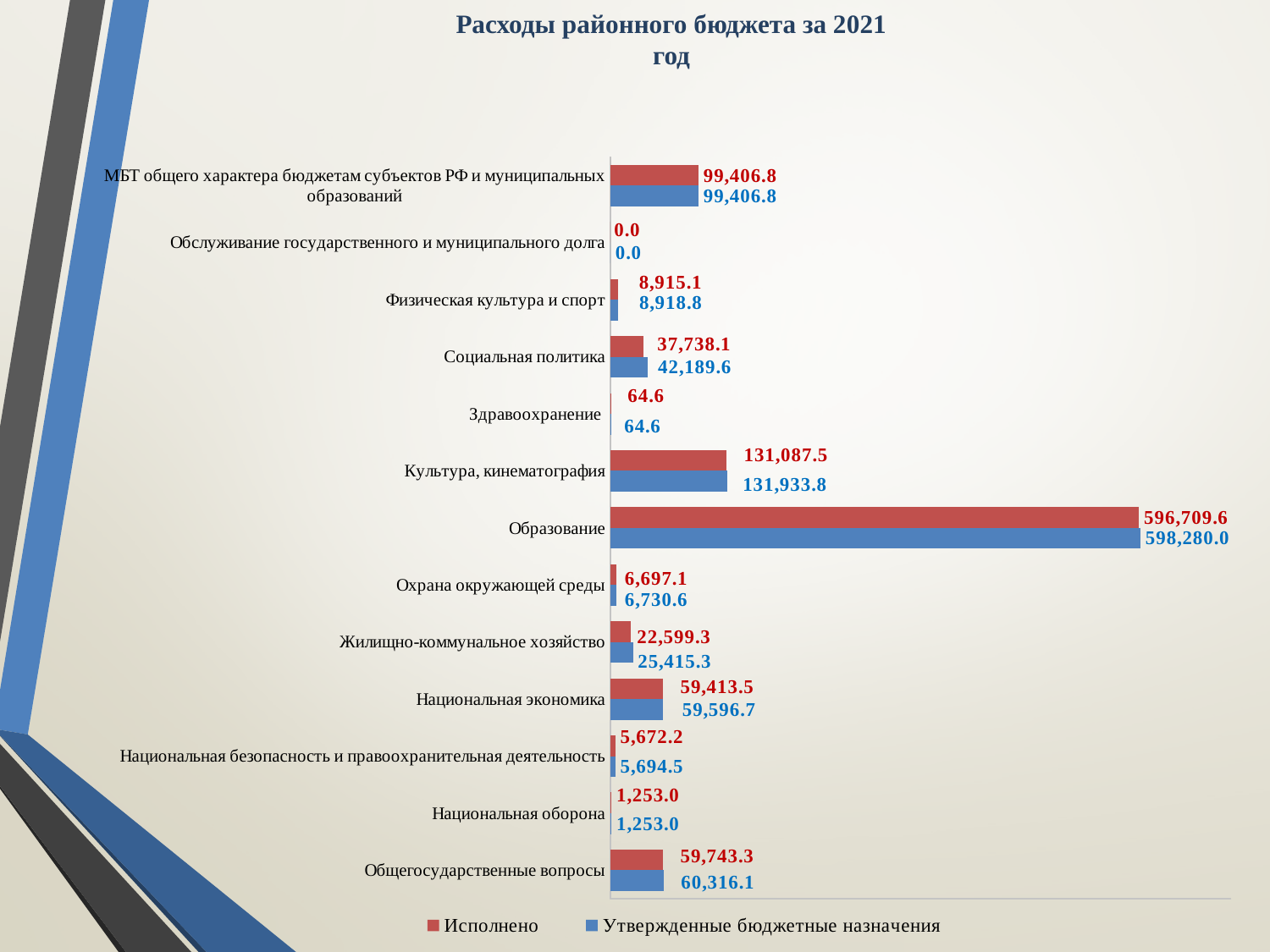
What type of chart is shown on the slide? Bar chart What is the difference between the Утвержденные бюджетные назначения and Исполнено values for Жилищно-коммунальное хозяйство? 2,816.0 Which category has the lowest Утвержденные бюджетные назначения value? Обслуживание государственного и муниципального долга What is the difference between the Утвержденные бюджетные назначения and Исполнено values for Социальная политика? 4,451.5 What is the Утвержденные бюджетные назначения value for Социальная политика? 42,189.6 How many categories are shown on the chart? 13 What is the title of the chart? Расходы районного бюджета за 2021 год What is the Исполнено value for Культура, кинематография? 131,087.5 How many series does the legend list? 2 What is the Исполнено value for Образование? 596,709.6 Which category has the highest Исполнено value? Образование Which is larger: the Исполнено value for Общегосударственные вопросы or the Исполнено value for Национальная экономика? Общегосударственные вопросы